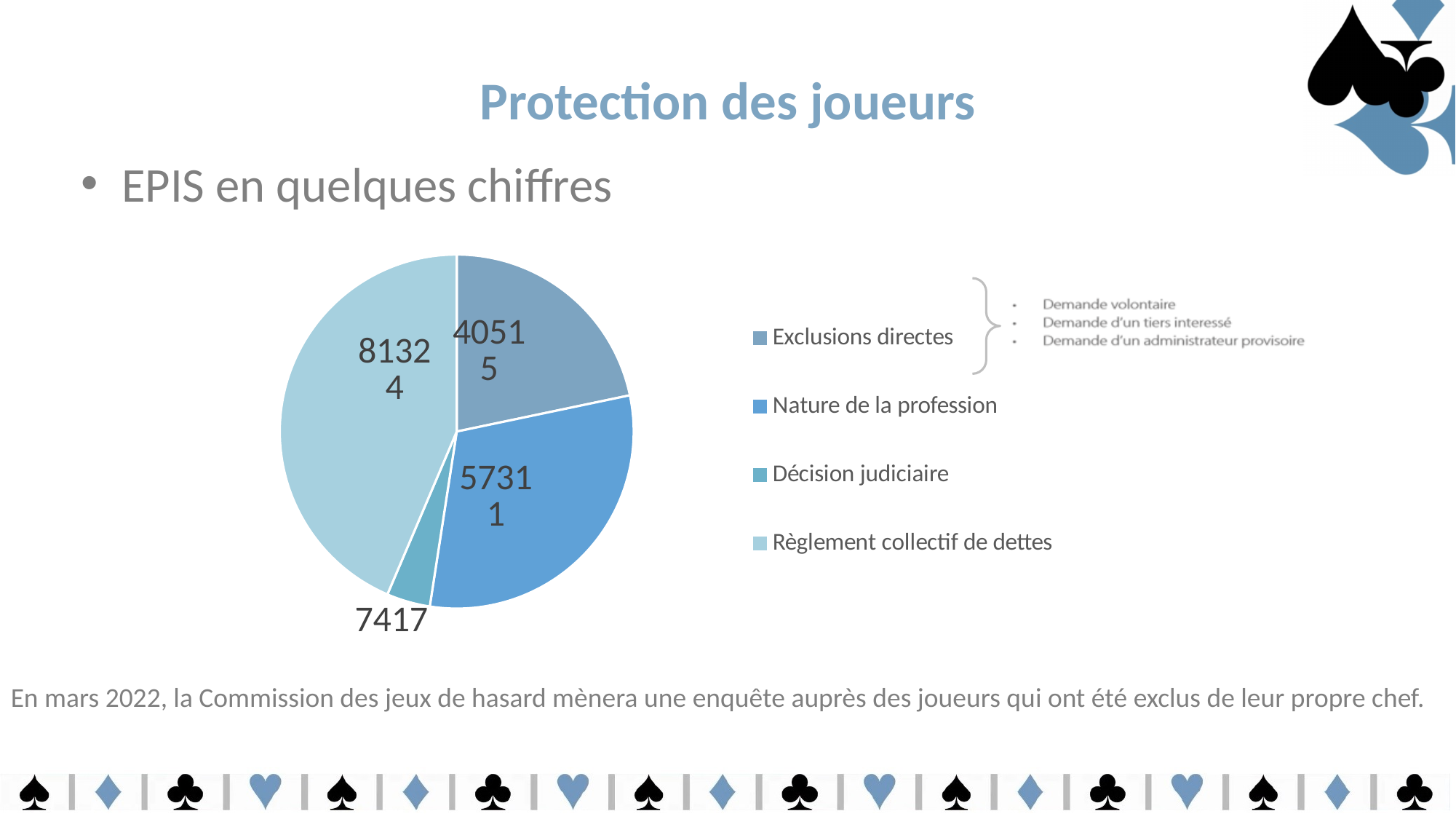
What is the value shown for Nature de la profession in the pie chart? 57311 How many entries does the legend of the pie chart list? 4 Which category has the smallest slice in the pie chart? Décision judiciaire What is the value shown for Décision judiciaire in the pie chart? 7417 What kind of chart is shown on the slide? pie chart What is the value shown for Règlement collectif de dettes in the pie chart? 81324 What is the difference between the values for Règlement collectif de dettes and Nature de la profession? 24013 Which category has the largest slice in the pie chart? Règlement collectif de dettes Which is larger in the pie chart: Nature de la profession or Exclusions directes? Nature de la profession What is the value shown for Exclusions directes in the pie chart? 40515 How many slices does the pie chart have? 4 Which legend entry is shown with the lightest blue colour in the pie chart? Règlement collectif de dettes